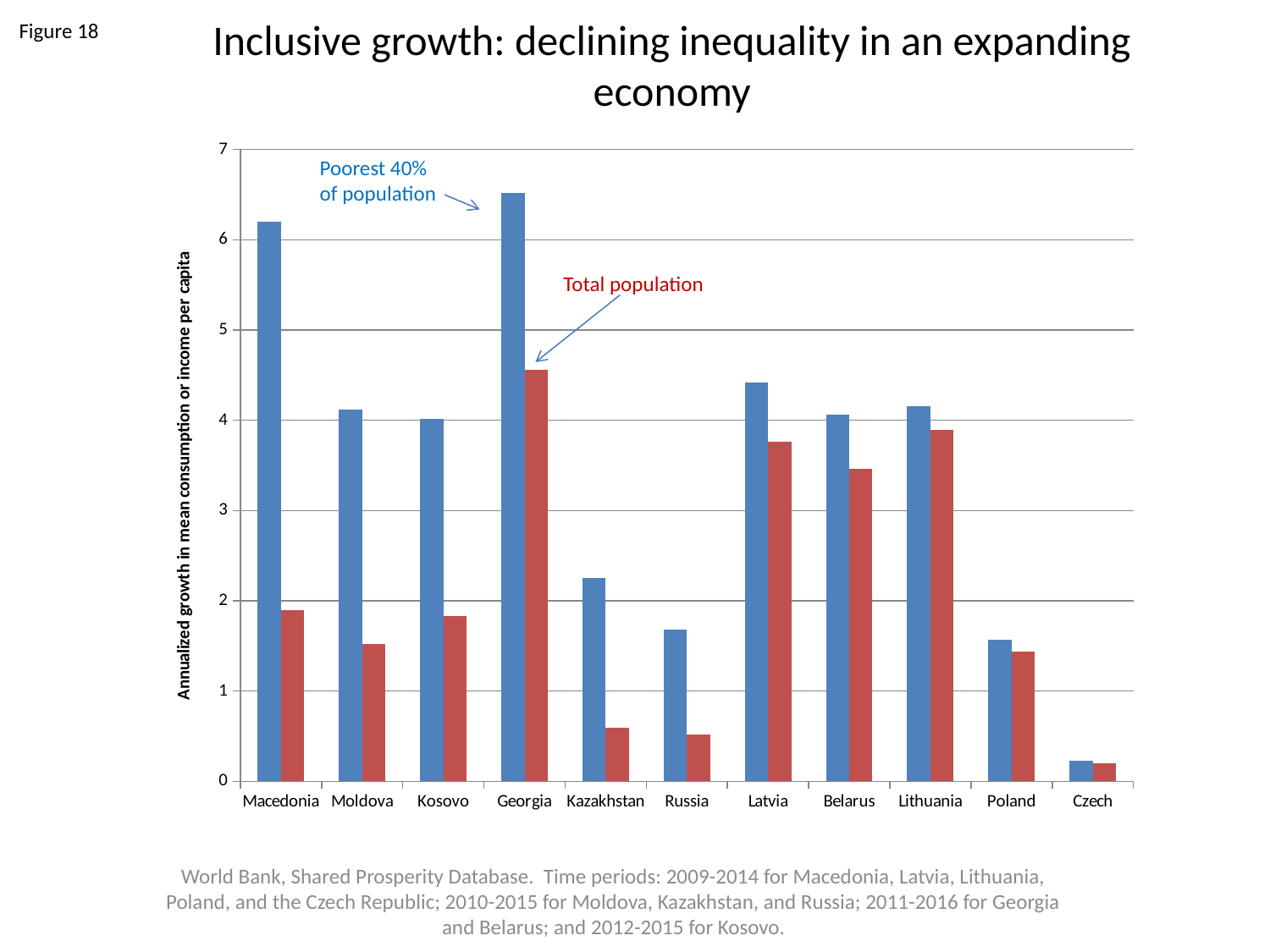
For Macedonia, which is larger: the Poorest 40% of population value or the Total population value? Poorest 40% of population Is the Poorest 40% of population value for Macedonia greater or less than 6? greater Is the Total population value for Georgia greater or less than 4? greater How many countries are shown on the x axis of the chart? 11 Which country has the highest value for the Total population series? Georgia What kind of chart is shown on the slide? bar chart What is the label on the vertical axis of the chart? Annualized growth in mean consumption or income per capita Which country has the lowest value for the Poorest 40% of population series? Czech Is the Poorest 40% of population value for Latvia greater or less than 4? greater Which country has the highest value for the Poorest 40% of population series? Georgia How many data series does the chart show? 2